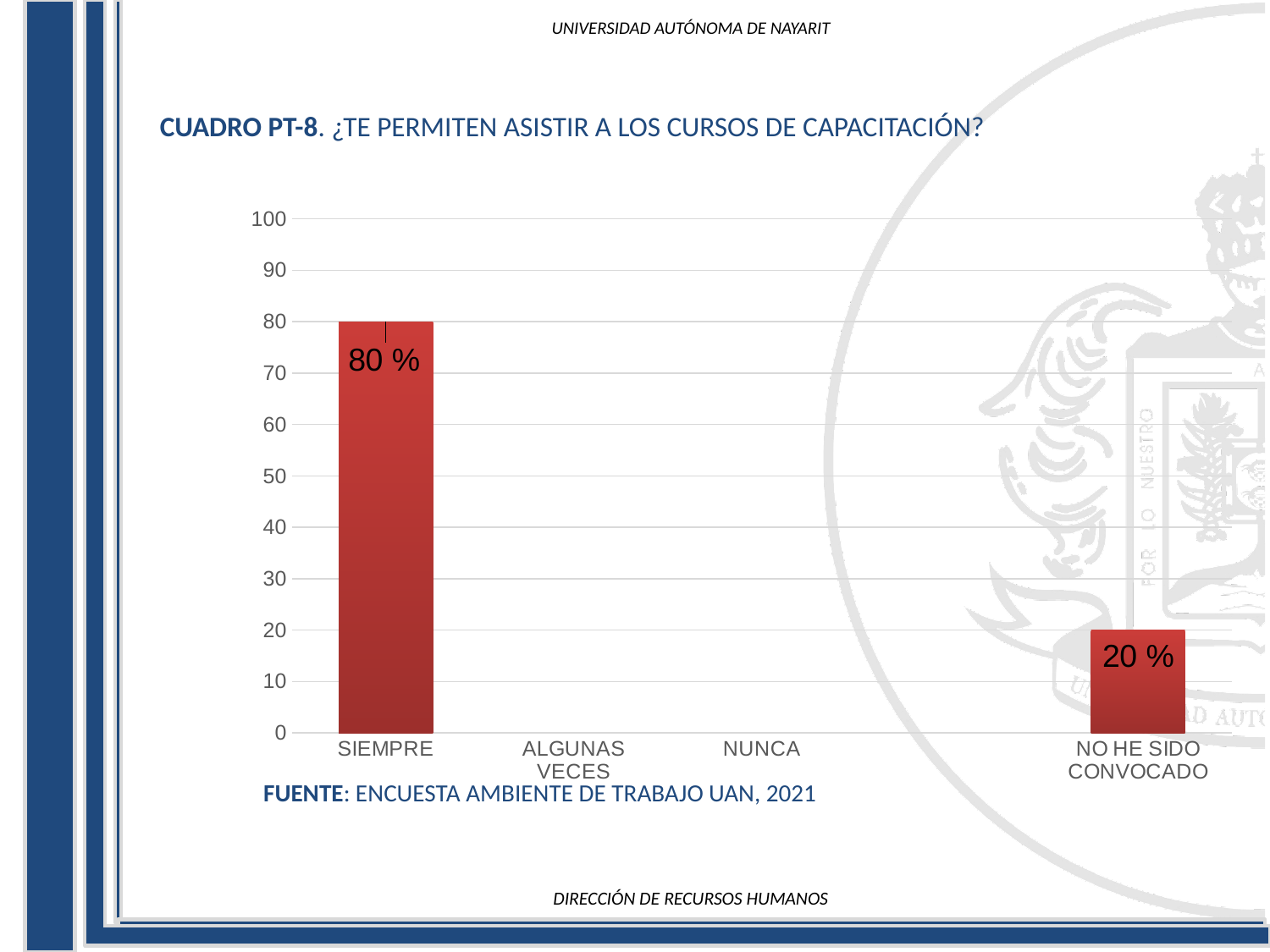
What is the title of the chart (CUADRO PT-8)? ¿TE PERMITEN ASISTIR A LOS CURSOS DE CAPACITACIÓN? Which is larger, the value for SIEMPRE or the value for NO HE SIDO CONVOCADO? SIEMPRE What is the value for NO HE SIDO CONVOCADO? 20 % Is the value for SIEMPRE greater or less than 50? greater What is the highest value shown on the y axis? 100 Is the value for NO HE SIDO CONVOCADO greater or less than 30? less How many categories are shown on the x axis? 4 Which category has the highest value? SIEMPRE What is the difference between the values for SIEMPRE and NO HE SIDO CONVOCADO? 60 % What is the value for SIEMPRE? 80 % What kind of chart is shown on the slide? bar chart